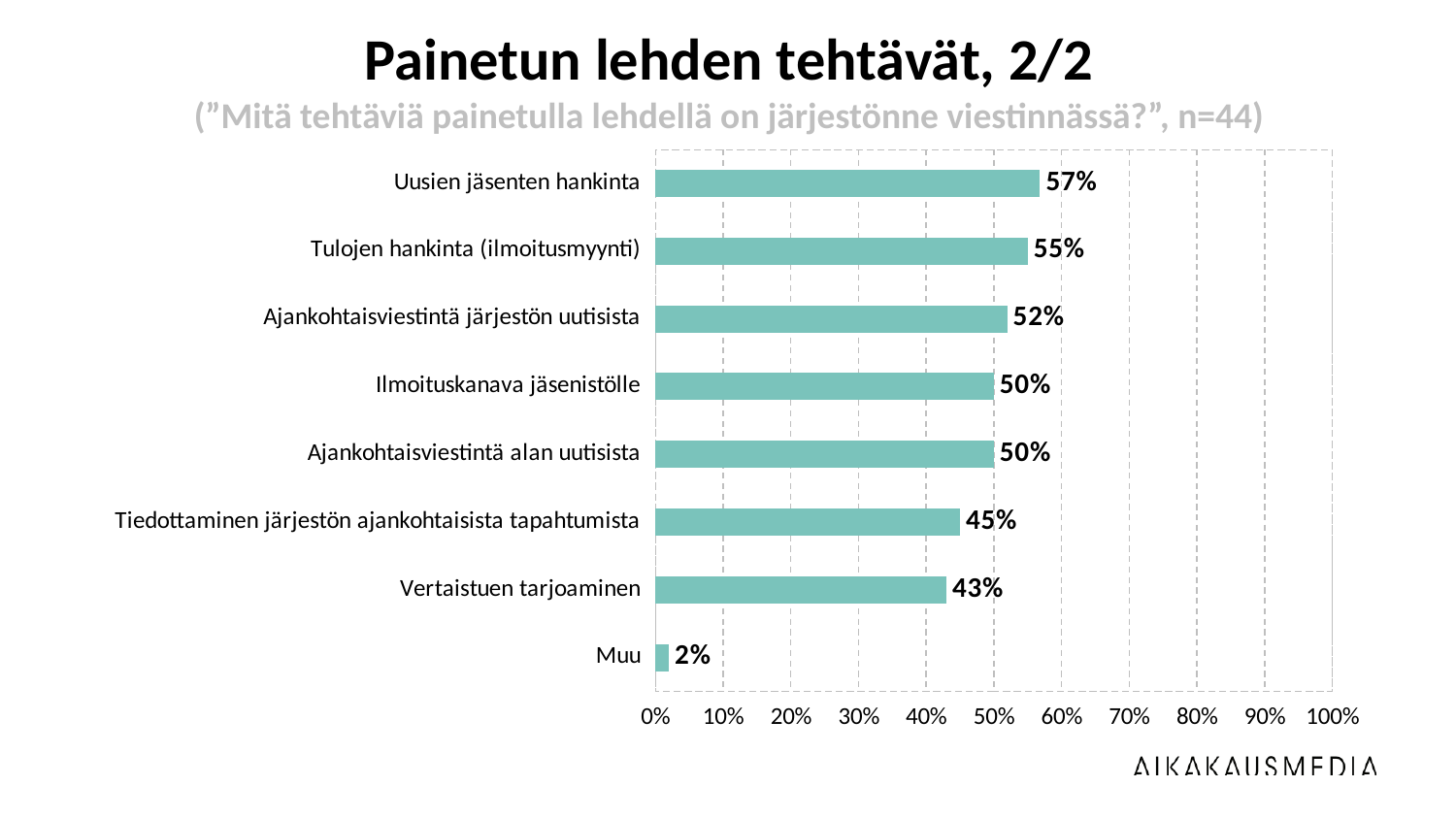
Which is larger, Ajankohtaisviestintä järjestön uutisista or Tiedottaminen järjestön ajankohtaisista tapahtumista? Ajankohtaisviestintä järjestön uutisista What is the title of the chart? Painetun lehden tehtävät, 2/2 Is the value for Ilmoituskanava jäsenistölle greater or less than 40%? greater How many categories are shown in the chart? 8 What is the value for Tulojen hankinta (ilmoitusmyynti)? 55% What is the difference between Uusien jäsenten hankinta and Vertaistuen tarjoaminen? 14% Which category has the lowest value? Muu What is the value for Vertaistuen tarjoaminen? 43% What is the value for Muu? 2% Which category has the highest value? Uusien jäsenten hankinta What is the value for Uusien jäsenten hankinta? 57% What kind of chart is shown on the slide? bar chart